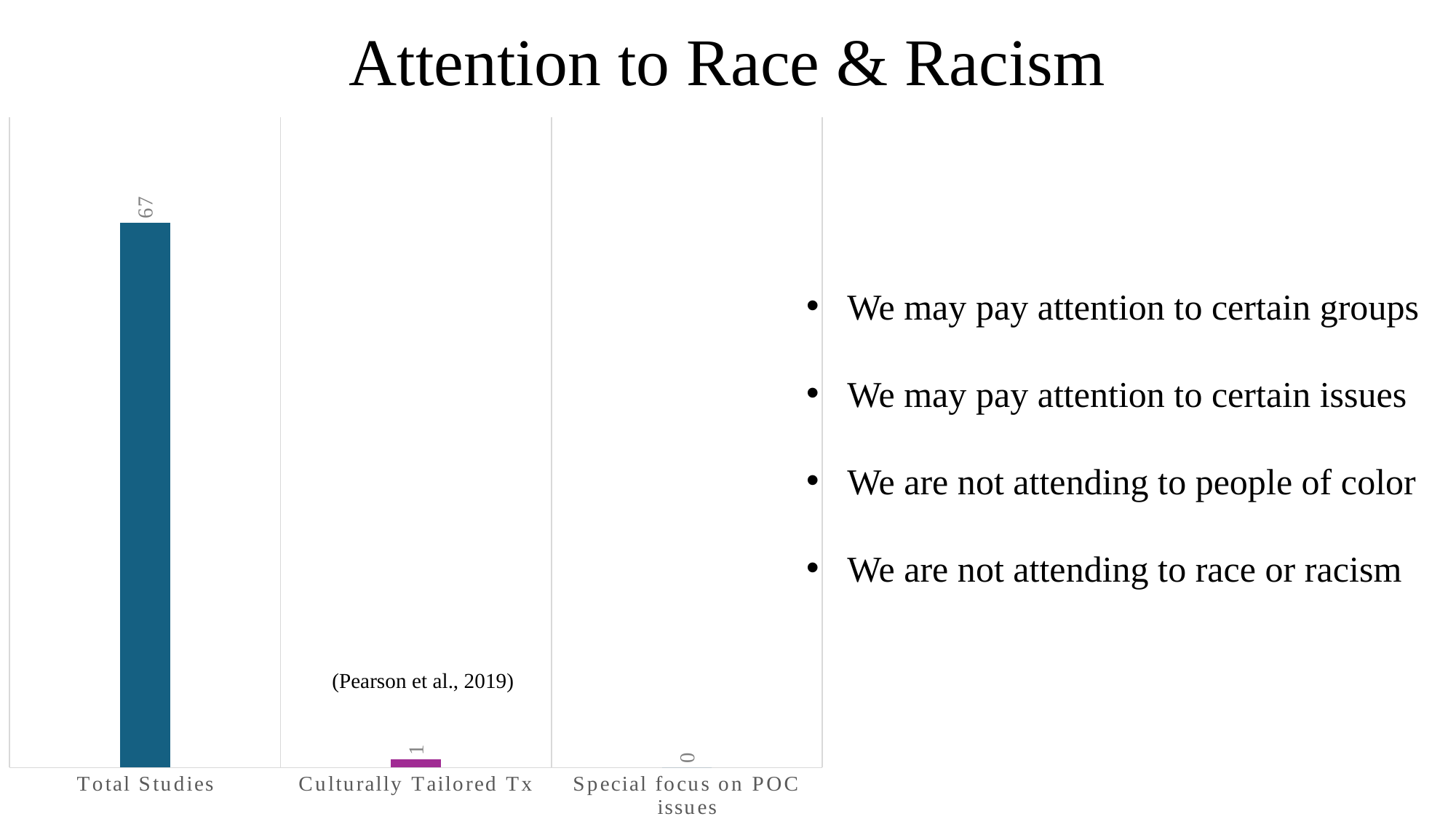
Which is larger, Culturally Tailored Tx or Special focus on POC issues? Culturally Tailored Tx Do the values rise or fall from left to right across the categories? Fall What is the value for Total Studies? 67 What is the value for Special focus on POC issues? 0 Which category has the highest value? Total Studies What is the title of the slide containing the chart? Attention to Race & Racism How many categories are shown on the chart? 3 What kind of chart is shown on the slide? Bar chart Which category has the lowest value? Special focus on POC issues What citation is printed on the chart? (Pearson et al., 2019) What is the difference between Total Studies and Culturally Tailored Tx? 66 What is the value for Culturally Tailored Tx? 1